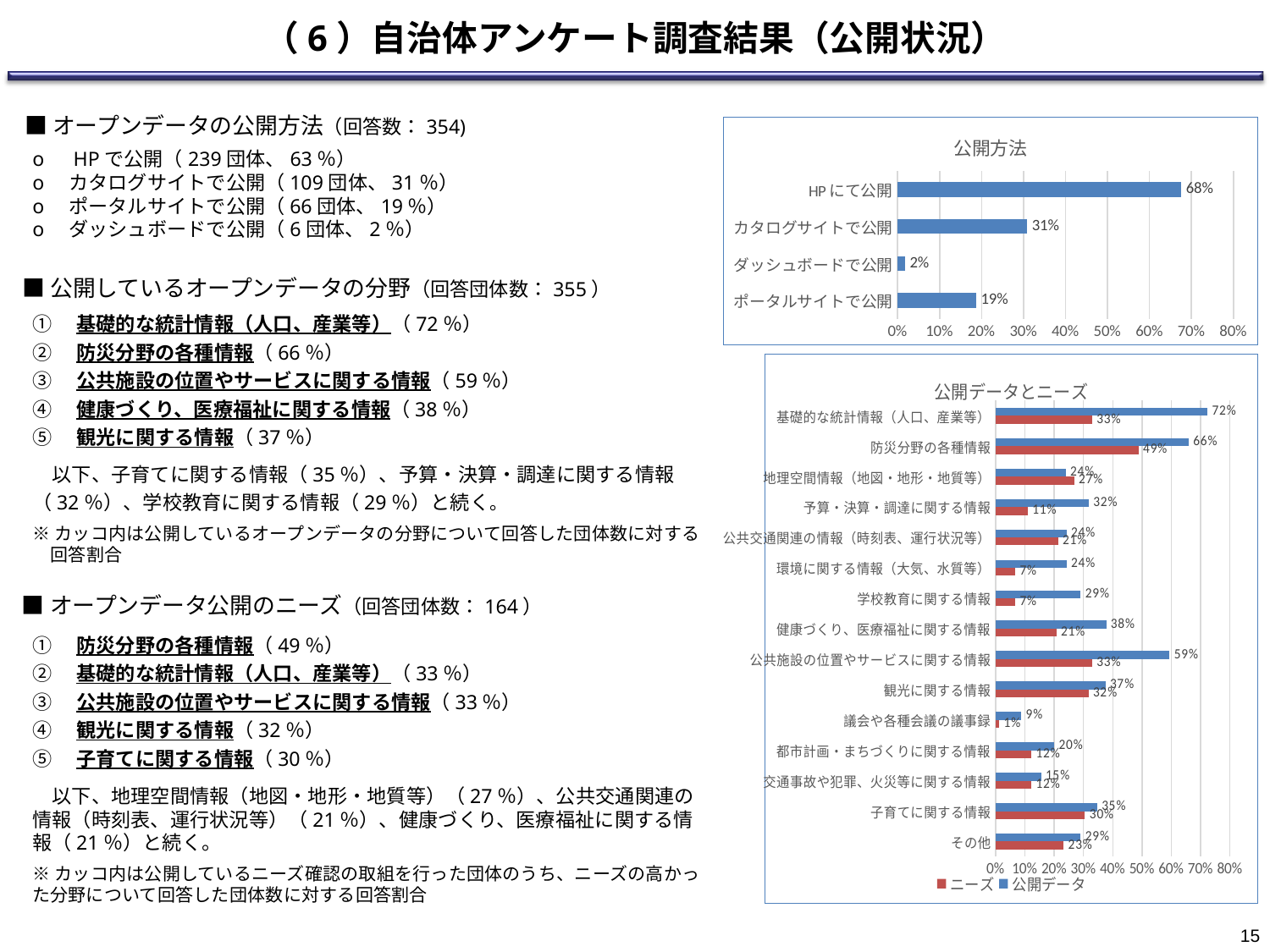
In the 公開データとニーズ chart, which category has the highest ニーズ value? 防災分野の各種情報 In the 公開方法 chart, what is the value for HPにて公開? 68% In the 公開データとニーズ chart, which is larger for 地理空間情報（地図・地形・地質等）: ニーズ or 公開データ? ニーズ In the 公開データとニーズ chart, what is the 公開データ value for 基礎的な統計情報（人口、産業等）? 72% In the 公開データとニーズ chart, how many categories are shown? 15 How many series does the legend of the 公開データとニーズ chart list? 2 In the 公開データとニーズ chart, what is the difference between the 公開データ and ニーズ values for 公共施設の位置やサービスに関する情報? 26% What kind of chart is the 公開方法 chart? Bar chart In the 公開方法 chart, which category has the lowest value? ダッシュボードで公開 In the 公開方法 chart, what is the difference between カタログサイトで公開 and ポータルサイトで公開? 12% In the 公開方法 chart, how many categories are shown? 4 In the 公開データとニーズ chart, what is the ニーズ value for 防災分野の各種情報? 49%